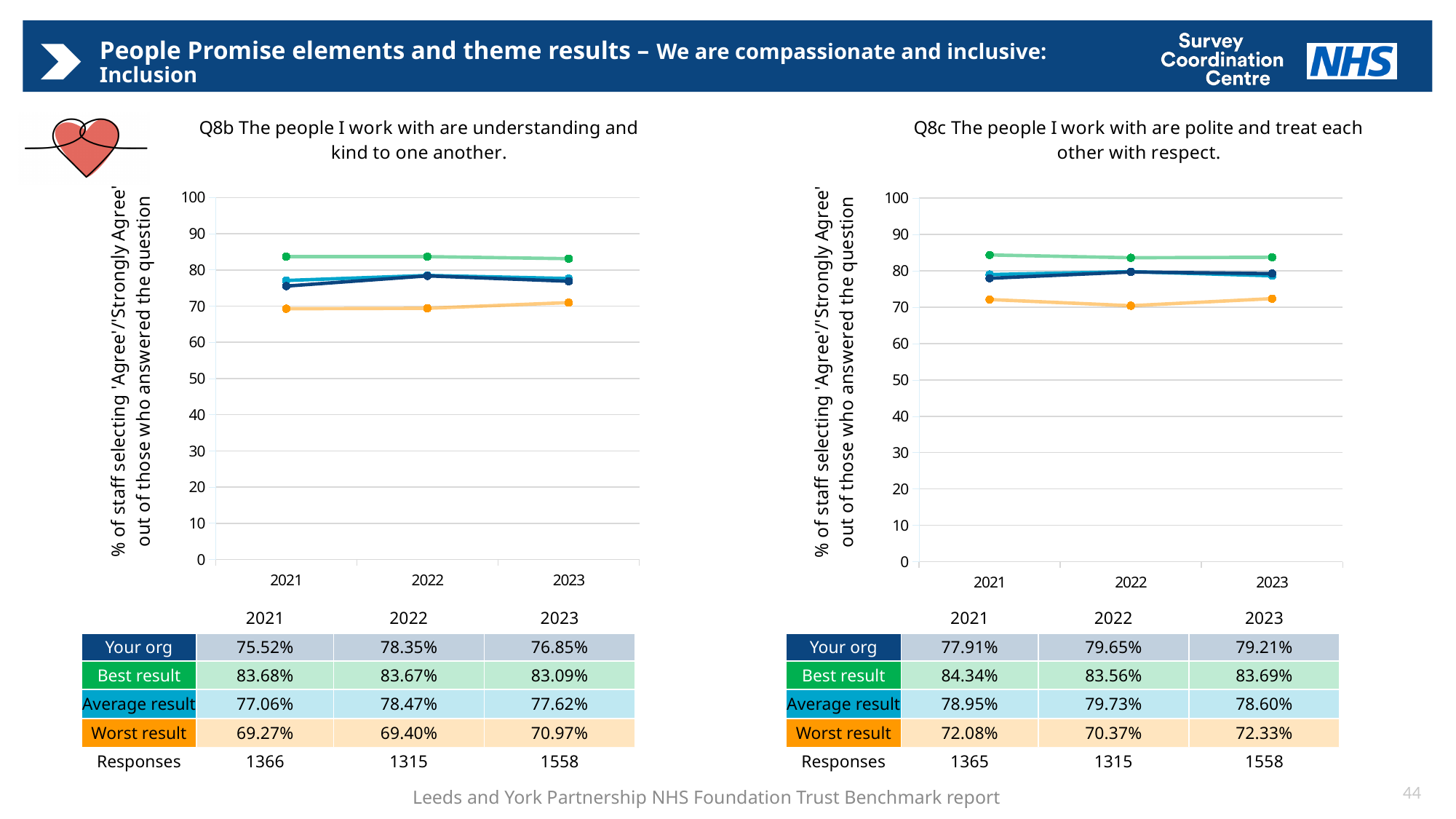
In the Q8c chart, did the 'Your org' value rise or fall from 2021 to 2022? Rise What kind of chart is used for Q8b? Line chart In the Q8c chart, what was the 'Average result' value in 2023? 78.60% In the Q8b chart, is the 'Worst result' value for 2021 greater or less than 70? less In the Q8b chart, what was the 'Best result' value in 2021? 83.68% How many years are plotted on the x axis of the Q8c chart? 3 In the Q8c chart, what was the 'Worst result' value in 2022? 70.37% In the Q8c chart, which is larger in 2022: the 'Your org' value or the 'Average result' value? Average result In the Q8b chart, what was the 'Your org' value in 2022? 78.35% In the Q8b chart, which year had the highest 'Your org' value? 2022 In the Q8b chart, what is the difference between the 'Best result' and 'Your org' values in 2023? 6.24 percentage points In the Q8c chart, which year had the lowest 'Worst result' value? 2022